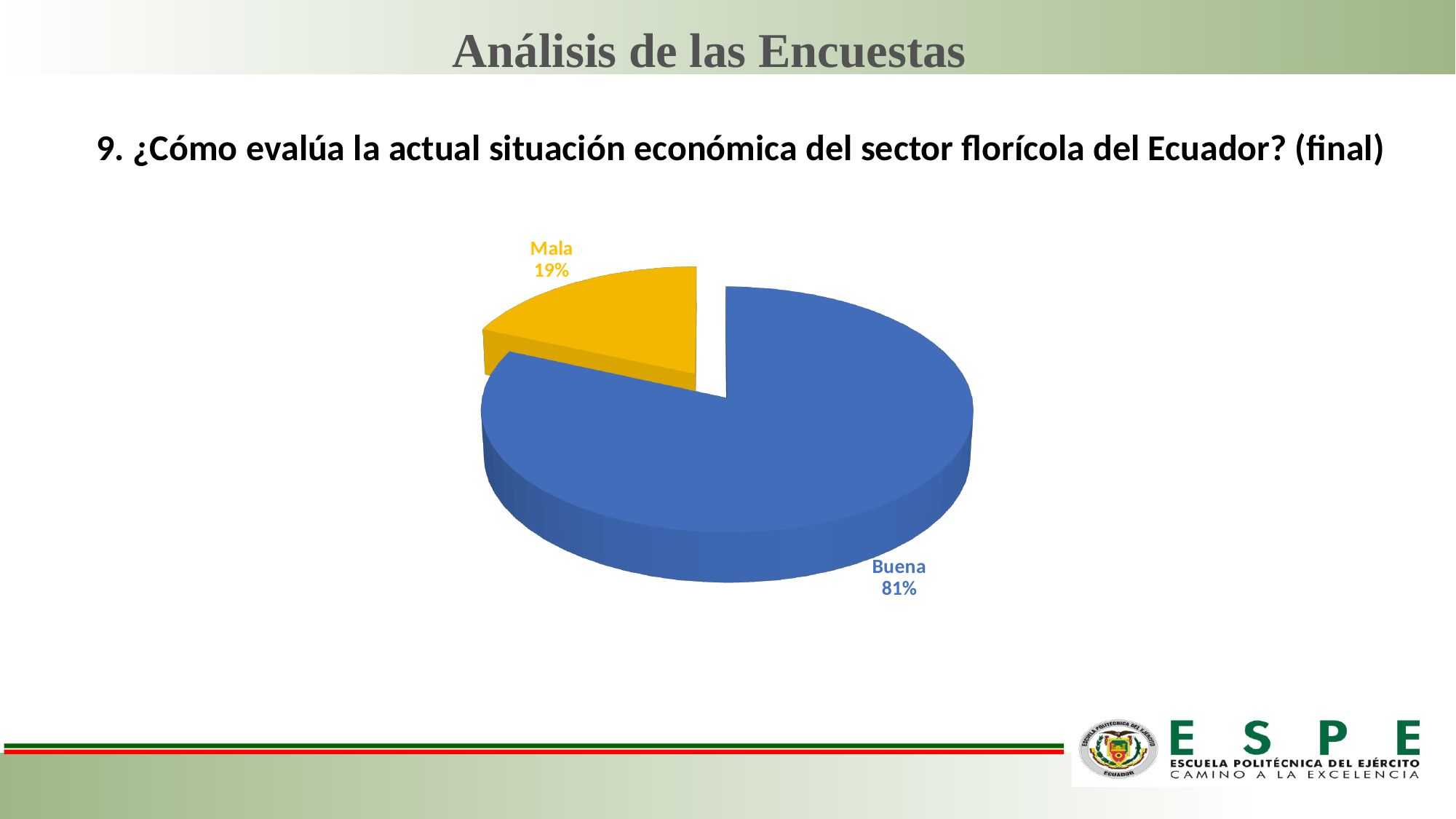
Which category has the largest share of the pie? Buena What kind of chart is shown on the slide? Pie chart How many categories are shown in the pie chart? 2 Which is larger, the share for Buena or the share for Mala? Buena What is the difference in percentage points between Buena and Mala? 62 What percentage of respondents evaluated the economic situation as Buena? 81% What percentage of respondents evaluated the economic situation as Mala? 19% What colour is the Buena slice? Blue Which category has the smallest share of the pie? Mala What share of the pie does the Mala slice represent? 19% What colour is the Mala slice? Yellow